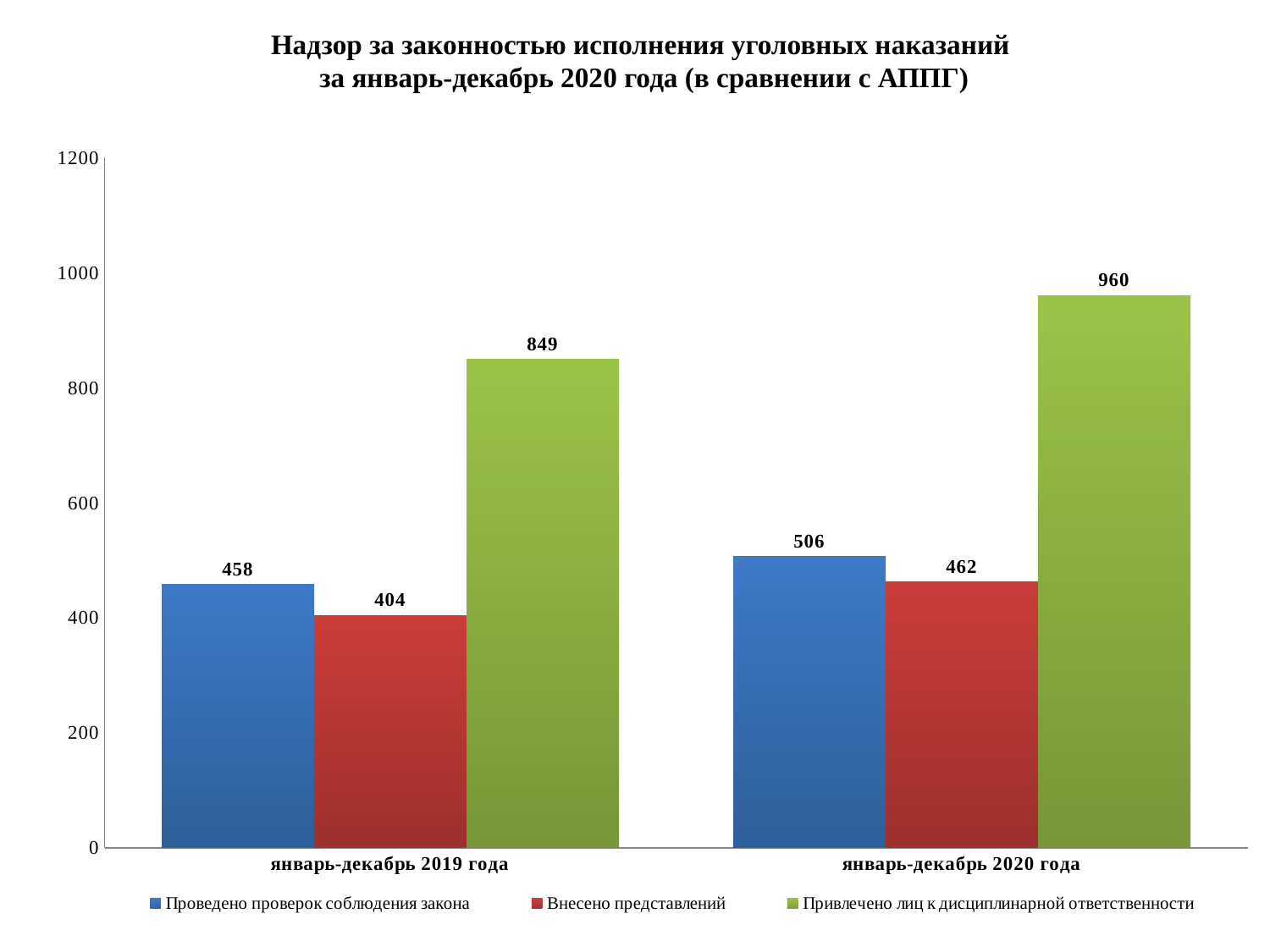
What kind of chart is shown on the slide? bar chart What is the value of "Привлечено лиц к дисциплинарной ответственности" for январь-декабрь 2019 года? 849 Does the value of "Внесено представлений" rise or fall from январь-декабрь 2019 года to январь-декабрь 2020 года? rise What is the difference between the values of "Привлечено лиц к дисциплинарной ответственности" for январь-декабрь 2020 года and январь-декабрь 2019 года? 111 Which series has the lowest value for январь-декабрь 2019 года? Внесено представлений What is the value of "Внесено представлений" for январь-декабрь 2020 года? 462 Which is larger: "Проведено проверок соблюдения закона" for январь-декабрь 2019 года or for январь-декабрь 2020 года? январь-декабрь 2020 года What is the difference between "Проведено проверок соблюдения закона" and "Внесено представлений" for январь-декабрь 2019 года? 54 What is the value of "Проведено проверок соблюдения закона" for январь-декабрь 2019 года? 458 How many series does the legend list? 3 Is the value of "Привлечено лиц к дисциплинарной ответственности" for январь-декабрь 2020 года greater or less than 1000? less Which series has the highest value for январь-декабрь 2020 года? Привлечено лиц к дисциплинарной ответственности